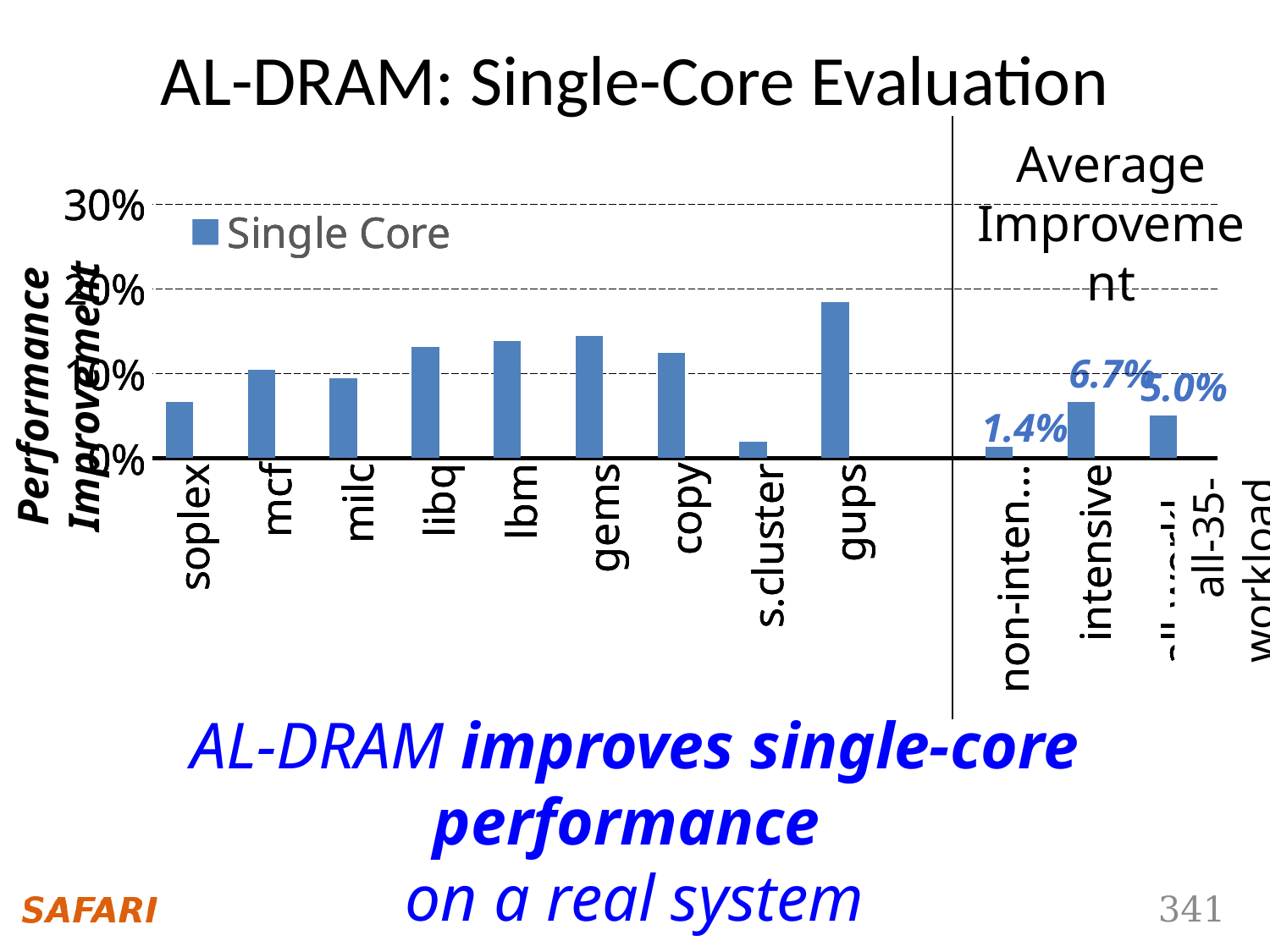
Which of the nine individual benchmark workloads (soplex through gups) has the lowest performance improvement? s.cluster What is the value for intensive? 6.7% Is the value for gups greater or less than 20%? less What is the difference between the values for intensive and non-intensive? 5.3% Which is larger, the value for gups or the value for lbm? gups Is the value for soplex greater or less than 10%? less How many series does the legend list? 1 What is the value for the non-intensive category? 1.4% What kind of chart is shown on the slide? bar chart Is the value for gups greater or less than 10%? greater What is the value for all-35-workload? 5.0% Which of the nine individual benchmark workloads (soplex through gups) has the highest performance improvement? gups